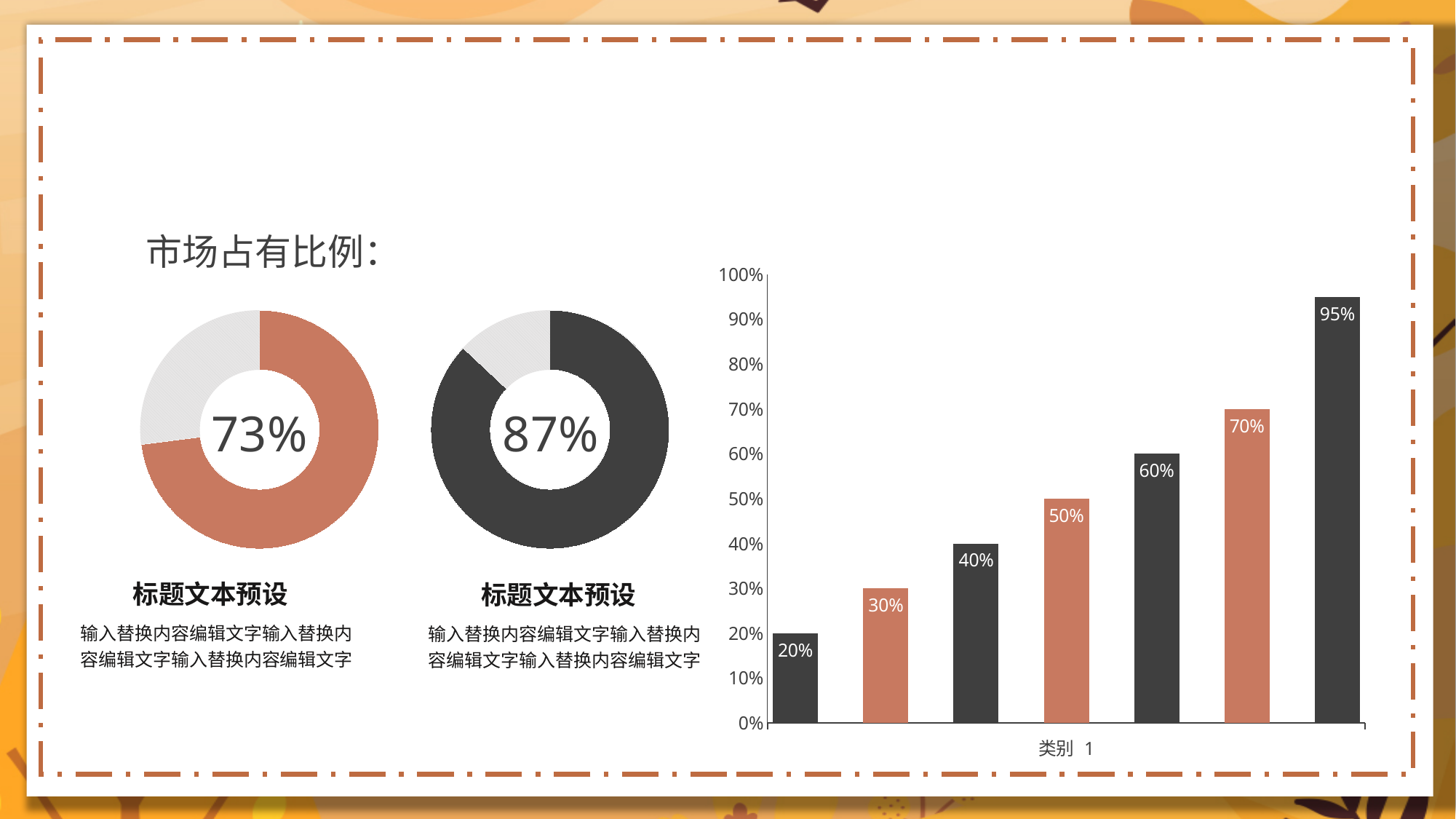
In the bar chart on the right, what is the difference between the rightmost bar and the leftmost bar? 75% In the bar chart on the right, what kind of chart is shown? bar chart In the bar chart on the right, what is the category label shown on the x axis? 类别 1 In the bar chart on the right, what is the difference between the sixth bar (70%) and the fifth bar (60%)? 10% In the bar chart on the right, what value is printed on the fourth bar from the left? 50% In the bar chart on the right, what value is printed on the second bar from the left? 30% What percentage is shown in the centre of the left donut chart? 73% In the bar chart on the right, what value is printed on the shortest bar? 20% What percentage is shown in the centre of the middle (dark) donut chart? 87% In the bar chart on the right, what value is printed on the tallest bar? 95% In the bar chart on the right, how many bars are plotted? 7 In the bar chart on the right, do the bar values rise or fall from left to right? rise